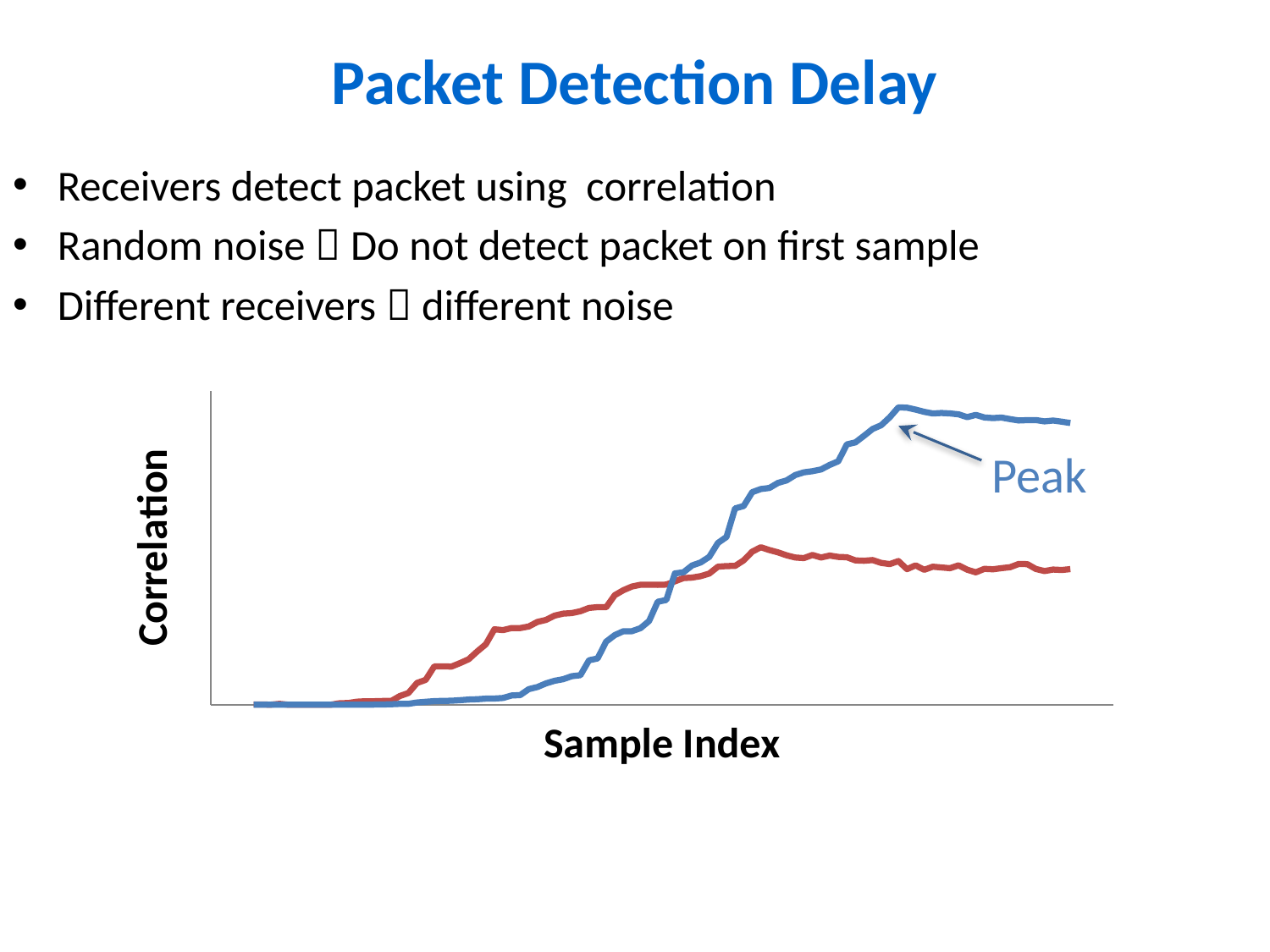
Which line starts rising earlier along the sample index axis, the blue line or the red line? The red line Do the correlation values generally rise or fall as the sample index increases? Rise Which line reaches a higher correlation value, the blue line or the red line? The blue line What kind of chart is shown on the slide? Line chart How many lines are plotted on the chart? 2 What is the label of the vertical axis of the chart? Correlation Does the red line level off at a higher or lower correlation than the blue line? Lower Which line does the arrow labelled "Peak" point to? The blue line What is the label of the horizontal axis of the chart? Sample Index